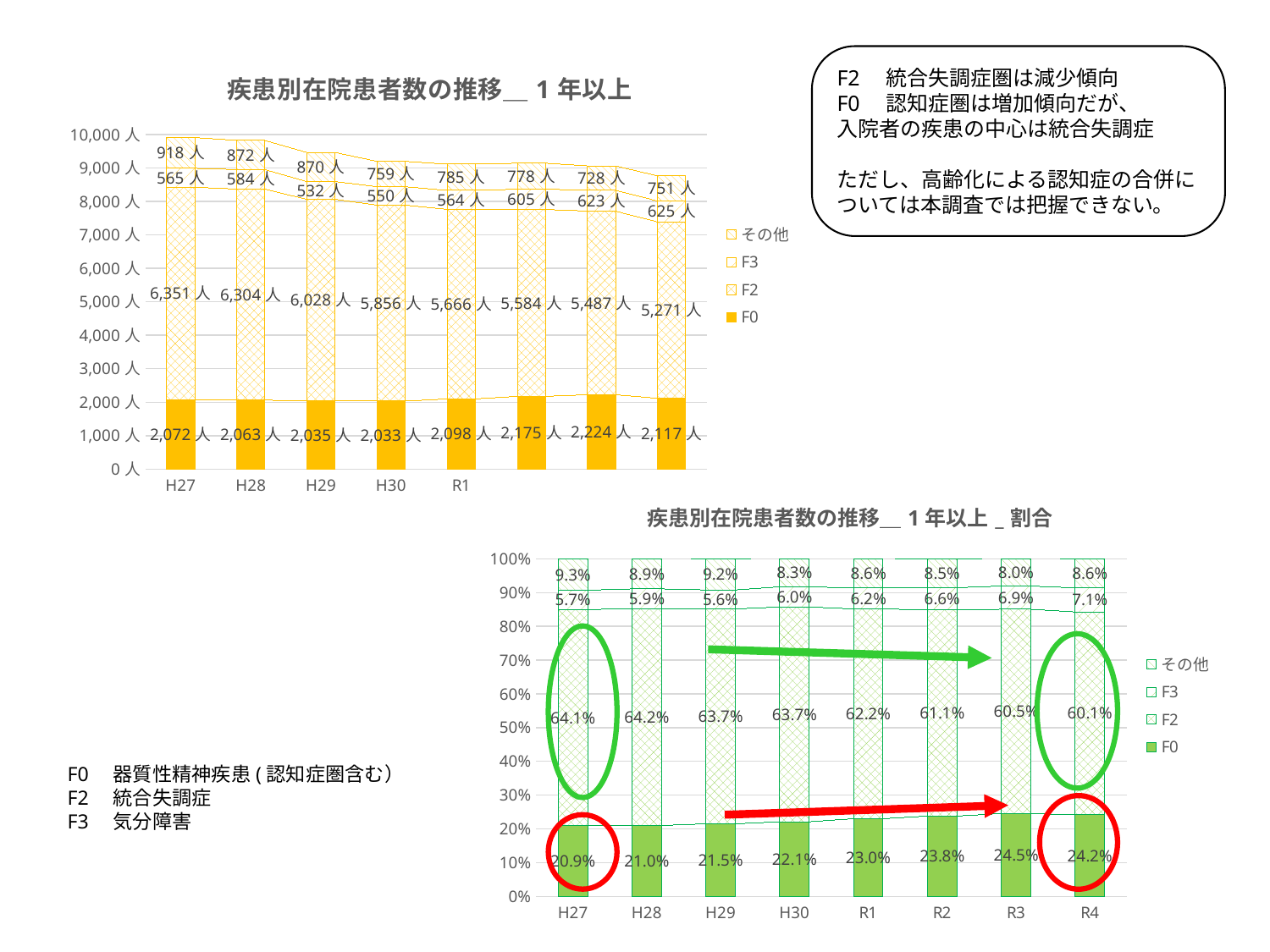
In the top chart (疾患別在院患者数の推移＿1年以上), what is the その他 value for H30? 759人 In the bottom chart (疾患別在院患者数の推移＿1年以上＿割合), how many years are shown on the x axis? 8 In the bottom chart (疾患別在院患者数の推移＿1年以上＿割合), which year has the highest F0 share? R3 In the top chart (疾患別在院患者数の推移＿1年以上), what is the total of the stacked bar for H27? 9,906人 What kind of chart is the top chart (疾患別在院患者数の推移＿1年以上)? Stacked bar chart In the bottom chart (疾患別在院患者数の推移＿1年以上＿割合), what is the F2 share for H27? 64.1% In the top chart (疾患別在院患者数の推移＿1年以上), what is the F2 value for R1? 5,666人 In the bottom chart (疾患別在院患者数の推移＿1年以上＿割合), what is the F0 share for R4? 24.2% In the bottom chart (疾患別在院患者数の推移＿1年以上＿割合), does the F2 share rise or fall from H27 to R4? Fall In the top chart (疾患別在院患者数の推移＿1年以上), how many series does the legend list? 4 In the top chart (疾患別在院患者数の推移＿1年以上), what is the difference between the F2 value for H27 and the F2 value for R1? 685人 In the top chart (疾患別在院患者数の推移＿1年以上), what is the F0 value for H27? 2,072人